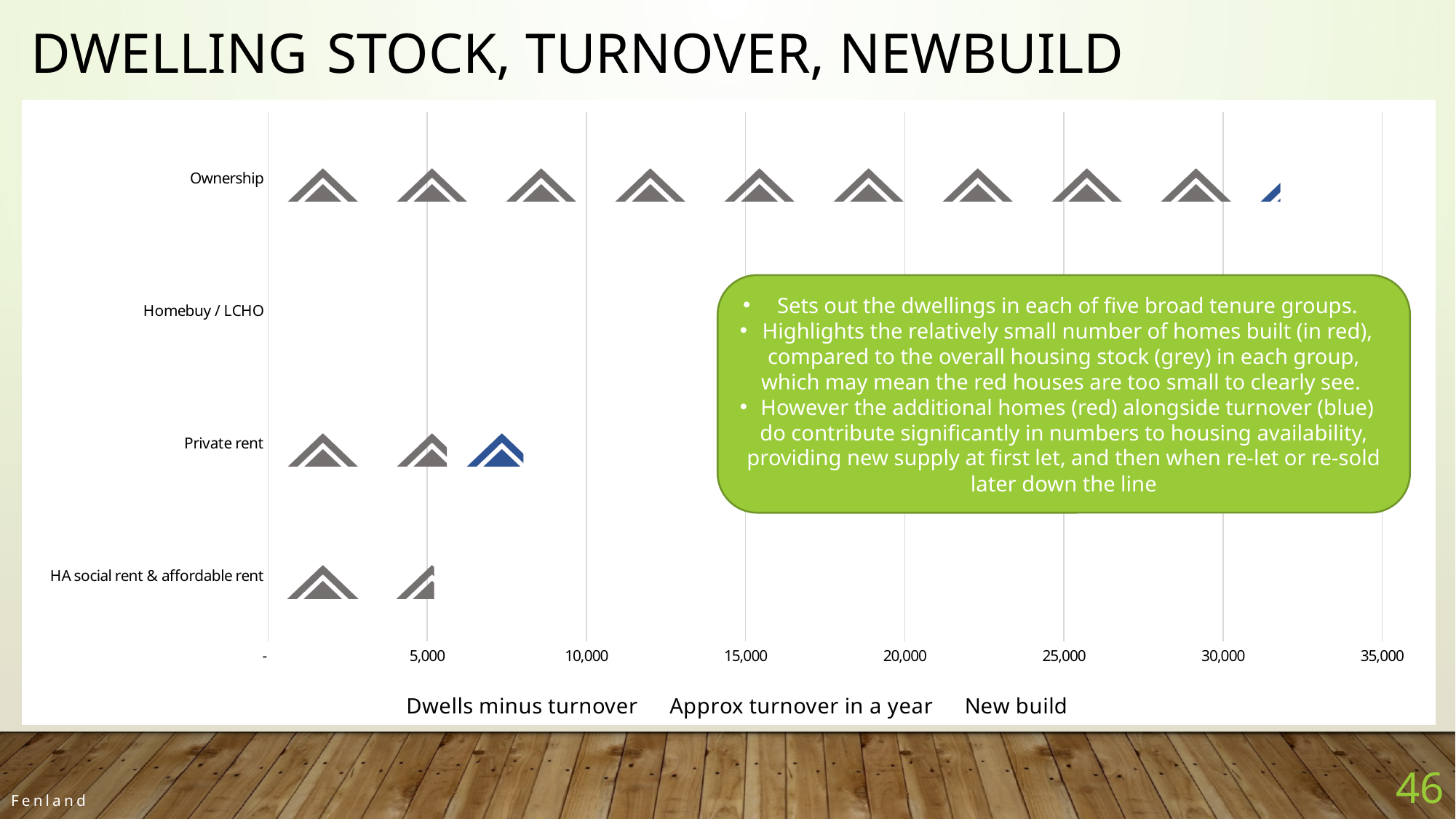
What kind of chart is shown on the slide? bar chart Which has a larger total dwelling stock, Private rent or HA social rent & affordable rent? Private rent How many series does the chart legend list? 3 Which tenure category has the largest total dwelling stock in the chart? Ownership What is the title of the chart slide? DWELLING STOCK, TURNOVER, NEWBUILD Is the total value for Ownership greater or less than 30,000? greater How many tenure categories are listed on the vertical axis of the chart? 4 Is the total value for HA social rent & affordable rent greater or less than 5,000? greater Which tenure category shows the smallest (no visible) dwelling stock in the chart? Homebuy / LCHO Is the total value for Private rent greater or less than 5,000? greater Which legend entry is shown in blue in the chart? Approx turnover in a year